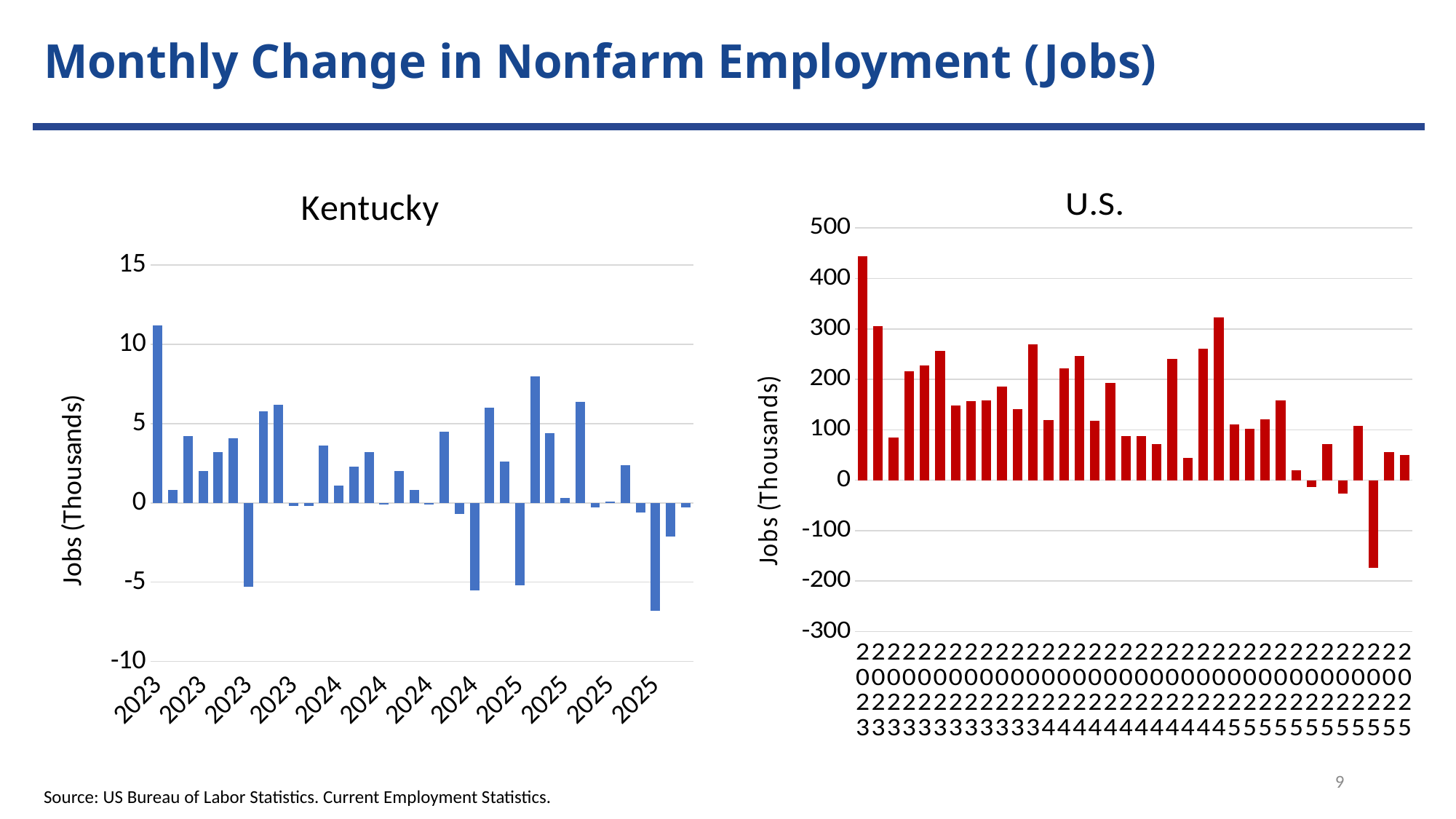
In the Kentucky chart, is the value of the tallest bar (the first 2023 bar) greater or less than 10? greater In the U.S. chart, is the value of the tallest bar (the first 2023 bar) greater or less than 400? greater What kind of chart is the Kentucky chart? bar chart In the U.S. chart, is the value of the lowest bar (in 2025) greater or less than -100? less What kind of chart is the U.S. chart? bar chart What colour are the bars in the U.S. chart? red In the Kentucky chart, which is larger: the first bar or the second bar? the first bar In the U.S. chart, do the monthly values generally rise or fall from 2023 to 2025? fall In the U.S. chart, in which year does the tallest bar appear? 2023 What is the y-axis label on the Kentucky chart? Jobs (Thousands)